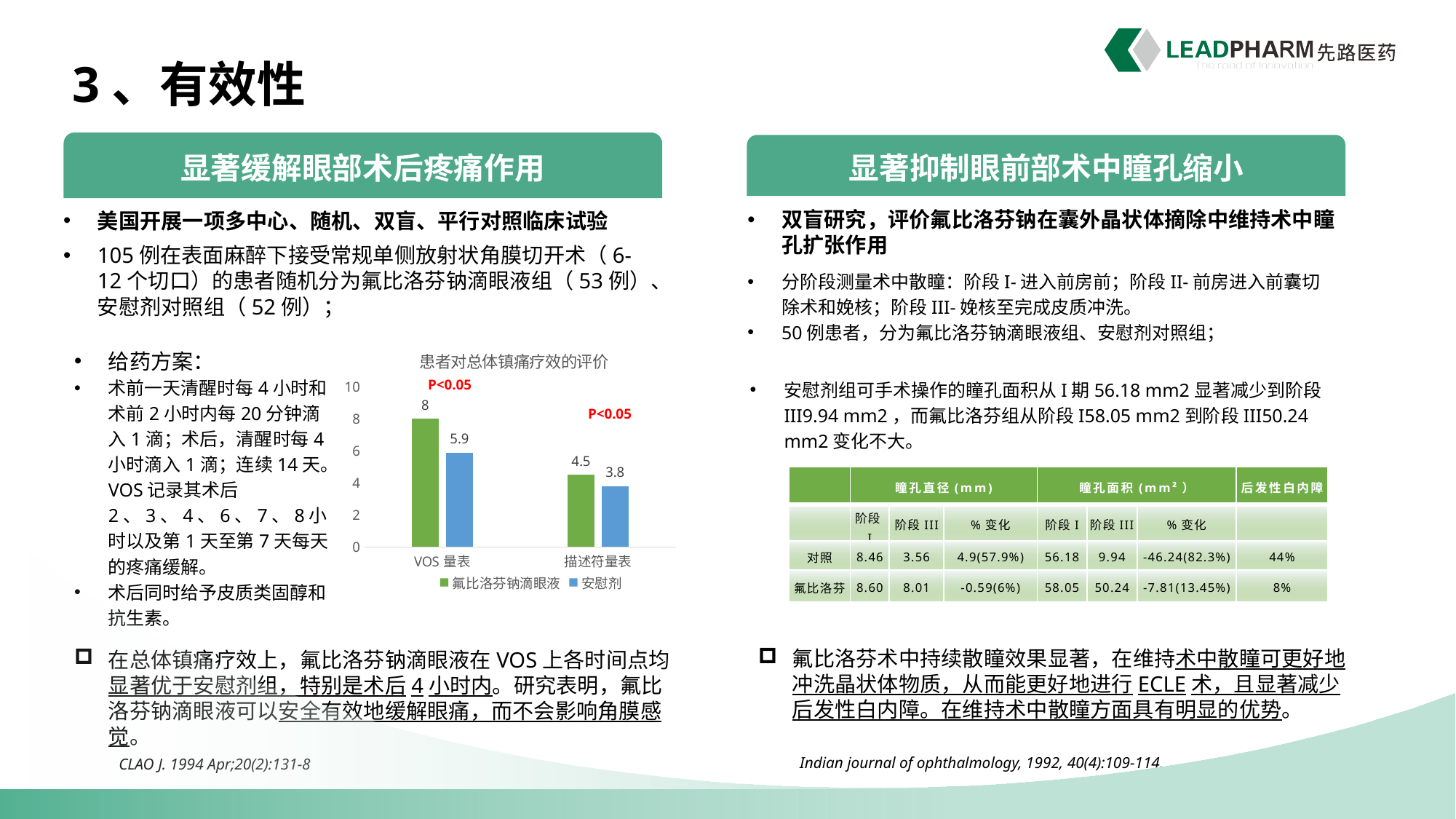
Which series has the higher value in the 描述符量表 category? 氟比洛芬钠滴眼液 What is the value for 安慰剂 in the 描述符量表 category? 3.8 What is the value for 氟比洛芬钠滴眼液 in the 描述符量表 category? 4.5 What is the value for 氟比洛芬钠滴眼液 in the VOS 量表 category? 8 How many series does the chart legend list? 2 Which bar in the chart has the highest value? 氟比洛芬钠滴眼液 in VOS 量表 What is the value for 安慰剂 in the VOS 量表 category? 5.9 What is the title of the chart? 患者对总体镇痛疗效的评价 Which colour represents 安慰剂 in the chart? blue How many categories are shown on the x axis of the chart? 2 What is the difference between 氟比洛芬钠滴眼液 and 安慰剂 in the VOS 量表 category? 2.1 What type of chart is shown on the slide? bar chart